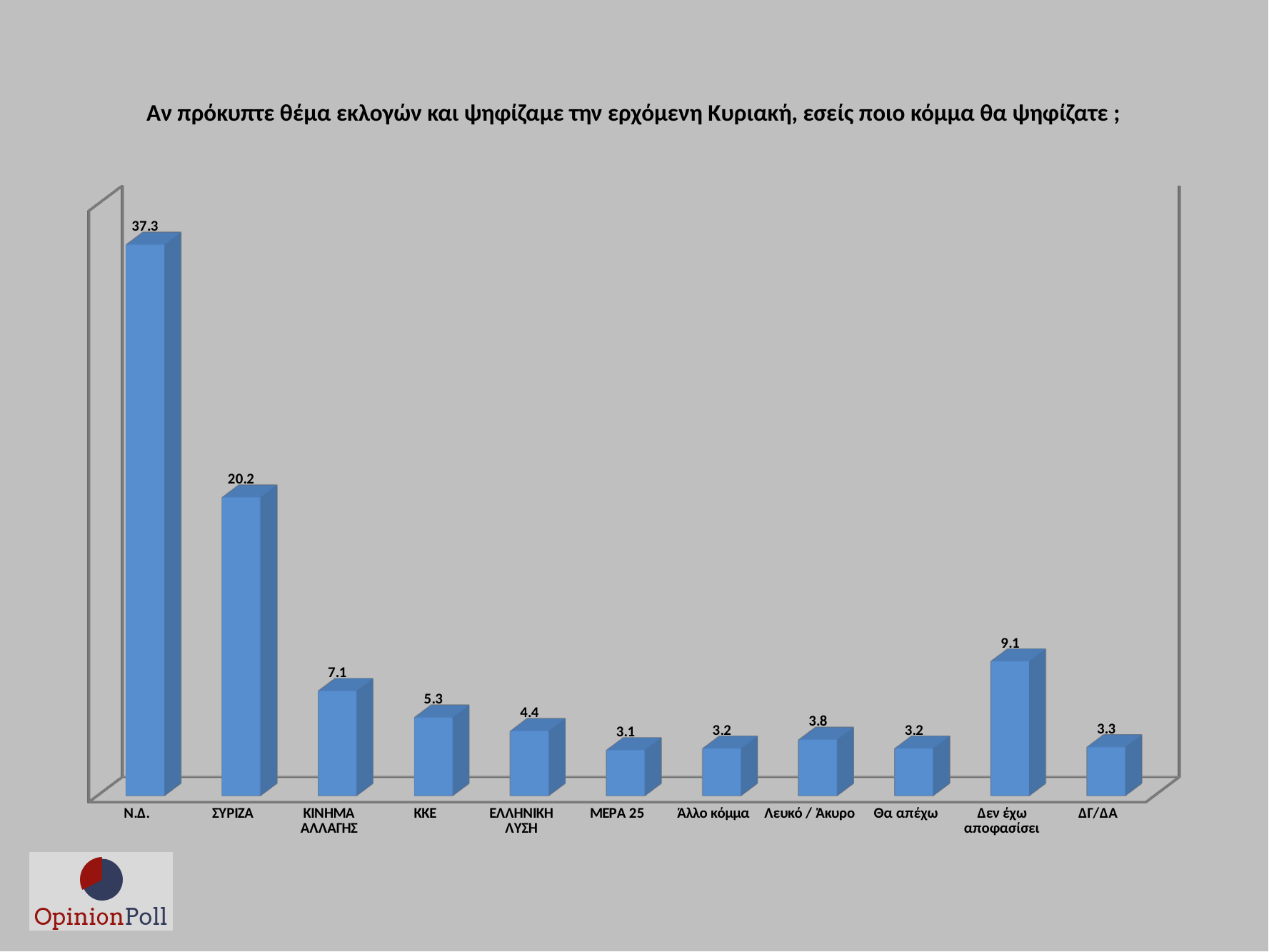
Which is larger, the value for ΚΚΕ or the value for ΕΛΛΗΝΙΚΗ ΛΥΣΗ? ΚΚΕ How many categories are shown on the x axis? 11 What is the difference between the values for Λευκό / Άκυρο and Θα απέχω? 0.6 What is the title of the chart? Αν πρόκυπτε θέμα εκλογών και ψηφίζαμε την ερχόμενη Κυριακή, εσείς ποιο κόμμα θα ψηφίζατε ; What is the value for ΚΙΝΗΜΑ ΑΛΛΑΓΗΣ? 7.1 What is the value for Ν.Δ.? 37.3 What kind of chart is shown on the slide? Bar chart Which category has the highest value? Ν.Δ. Which category has the lowest value? ΜΕΡΑ 25 What is the value for Δεν έχω αποφασίσει? 9.1 What is the difference between the values for Ν.Δ. and ΣΥΡΙΖΑ? 17.1 What is the value for ΣΥΡΙΖΑ? 20.2